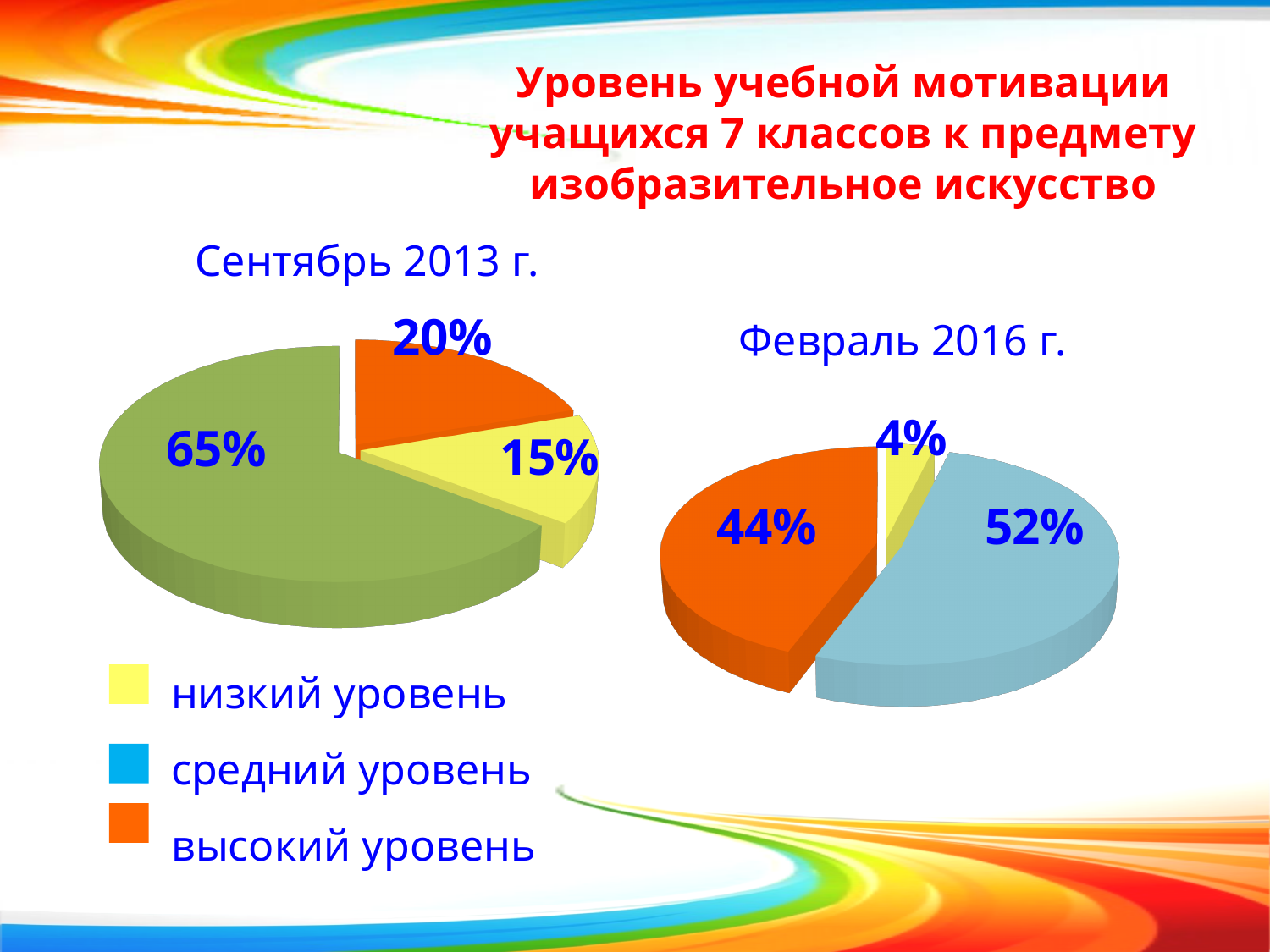
In the 'Февраль 2016 г.' chart, which level has the largest share? средний уровень In the 'Сентябрь 2013 г.' chart, which slice is the smallest? 15% (низкий уровень) What kind of charts are shown on the slide? Pie charts In the 'Сентябрь 2013 г.' chart, what is the value of the orange slice (высокий уровень)? 20% In the 'Февраль 2016 г.' chart, what is the value for средний уровень (blue slice)? 52% How many slices does the 'Февраль 2016 г.' pie chart have? 3 In the 'Февраль 2016 г.' chart, what is the value for низкий уровень (yellow slice)? 4% Which chart has the larger value for низкий уровень, 'Сентябрь 2013 г.' or 'Февраль 2016 г.'? Сентябрь 2013 г. What is the difference between the высокий уровень values in the 'Февраль 2016 г.' chart and the 'Сентябрь 2013 г.' chart? 24% In the 'Февраль 2016 г.' chart, what is the value for высокий уровень (orange slice)? 44% In the 'Сентябрь 2013 г.' chart, what is the value of the largest slice? 65% In the 'Сентябрь 2013 г.' chart, what is the value of the yellow slice (низкий уровень)? 15%